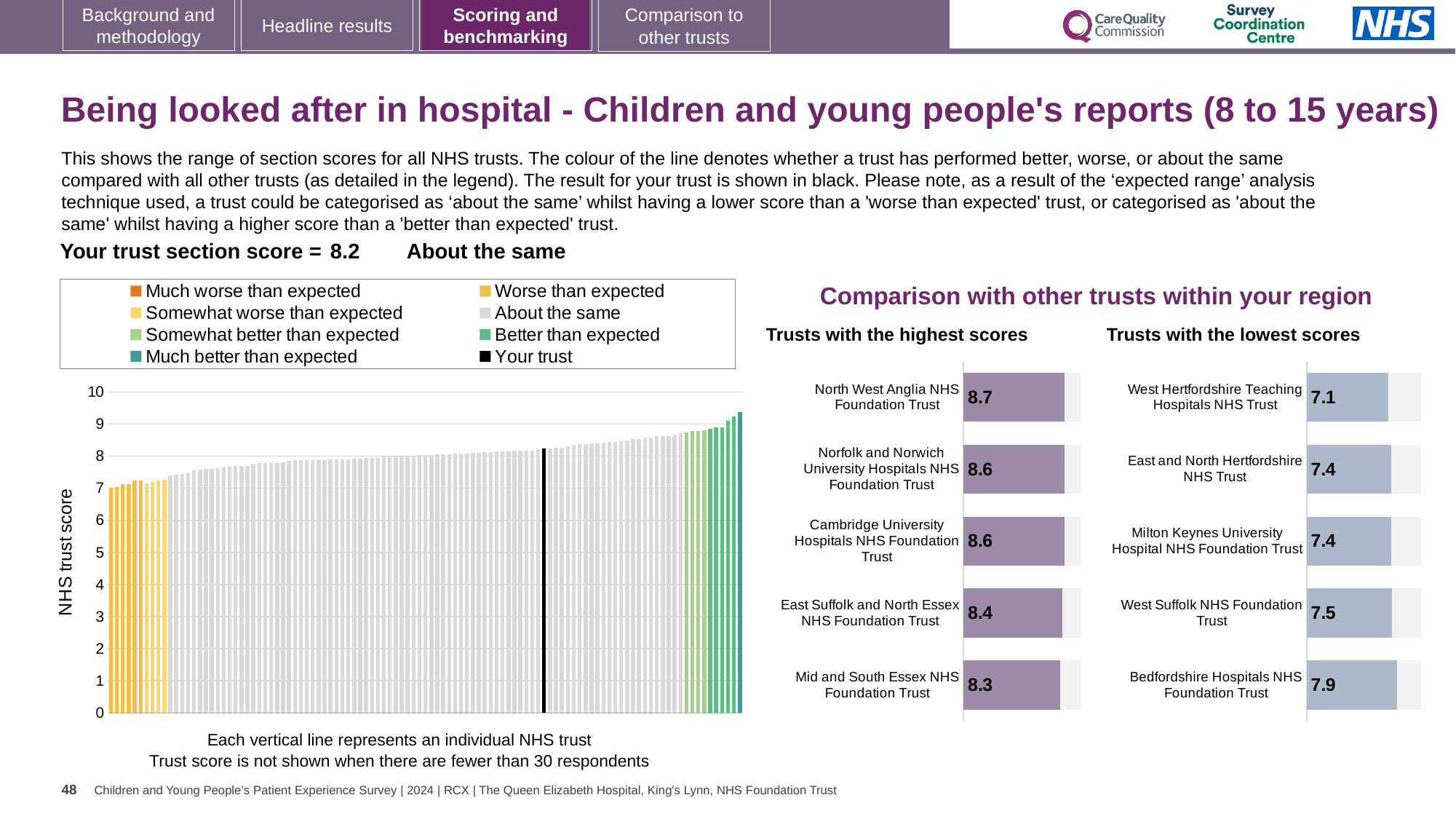
In the 'Trusts with the lowest scores' chart, which has the larger score: West Suffolk NHS Foundation Trust or Bedfordshire Hospitals NHS Foundation Trust? Bedfordshire Hospitals NHS Foundation Trust In the 'Trusts with the lowest scores' chart, which trust has the lowest score? West Hertfordshire Teaching Hospitals NHS Trust In the 'Trusts with the highest scores' chart, what is the difference between the scores of North West Anglia NHS Foundation Trust and Mid and South Essex NHS Foundation Trust? 0.4 In the 'NHS trust score' chart on the left, do the bars rise or fall from left to right? Rise In the 'NHS trust score' chart on the left, is the value of the tallest bar greater or less than 9? greater What kind of chart is the 'NHS trust score' chart on the left of the slide? Bar chart In the 'Trusts with the lowest scores' chart, what is the score for West Hertfordshire Teaching Hospitals NHS Trust? 7.1 In the 'Trusts with the highest scores' chart, which trust has the highest score? North West Anglia NHS Foundation Trust In the 'Trusts with the lowest scores' chart, what is the score for Bedfordshire Hospitals NHS Foundation Trust? 7.9 In the 'Trusts with the highest scores' chart, what is the score for North West Anglia NHS Foundation Trust? 8.7 How many trusts are shown in the 'Trusts with the highest scores' chart? 5 How many entries does the legend above the 'NHS trust score' chart list? 8